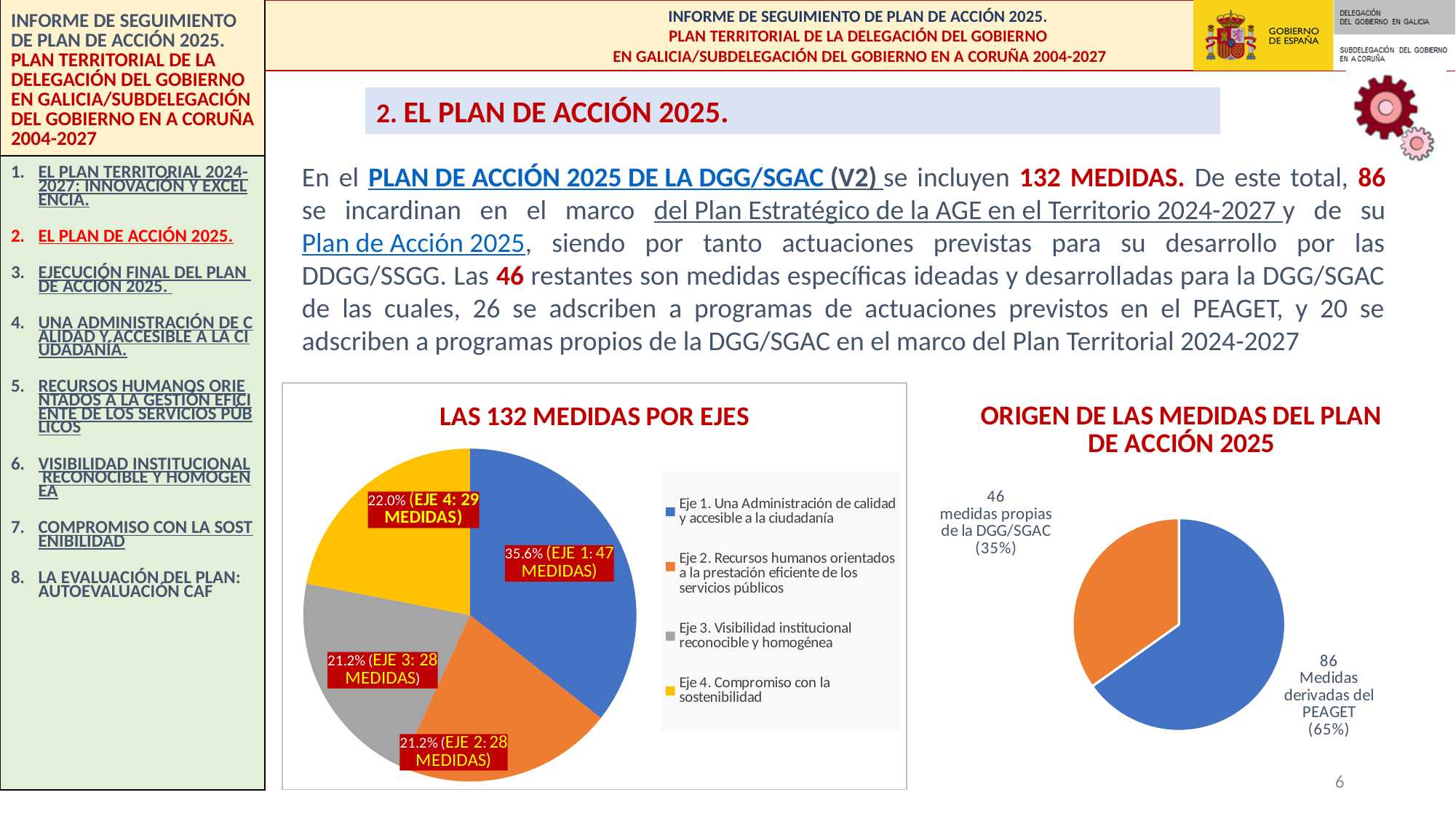
In the chart 'LAS 132 MEDIDAS POR EJES', how many measures belong to Eje 1? 47 In the chart 'ORIGEN DE LAS MEDIDAS DEL PLAN DE ACCIÓN 2025', what percentage share do the medidas propias de la DGG/SGAC have? 35% In the chart 'LAS 132 MEDIDAS POR EJES', what percentage share does Eje 4 have? 22.0% In the chart 'LAS 132 MEDIDAS POR EJES', which eje has the most measures? Eje 1 In the chart 'ORIGEN DE LAS MEDIDAS DEL PLAN DE ACCIÓN 2025', what is the difference between the medidas derivadas del PEAGET and the medidas propias de la DGG/SGAC? 40 In the chart 'ORIGEN DE LAS MEDIDAS DEL PLAN DE ACCIÓN 2025', which is larger: medidas propias de la DGG/SGAC or medidas derivadas del PEAGET? Medidas derivadas del PEAGET In the chart 'ORIGEN DE LAS MEDIDAS DEL PLAN DE ACCIÓN 2025', how many measures are derived from the PEAGET? 86 In the chart 'LAS 132 MEDIDAS POR EJES', what is the difference in number of measures between Eje 1 and Eje 4? 18 In the chart 'LAS 132 MEDIDAS POR EJES', how many slices does the pie have? 4 In the chart 'LAS 132 MEDIDAS POR EJES', how many measures does Eje 3 have? 28 In the chart 'LAS 132 MEDIDAS POR EJES', which colour represents Eje 2? Orange What type of chart is 'LAS 132 MEDIDAS POR EJES'? Pie chart